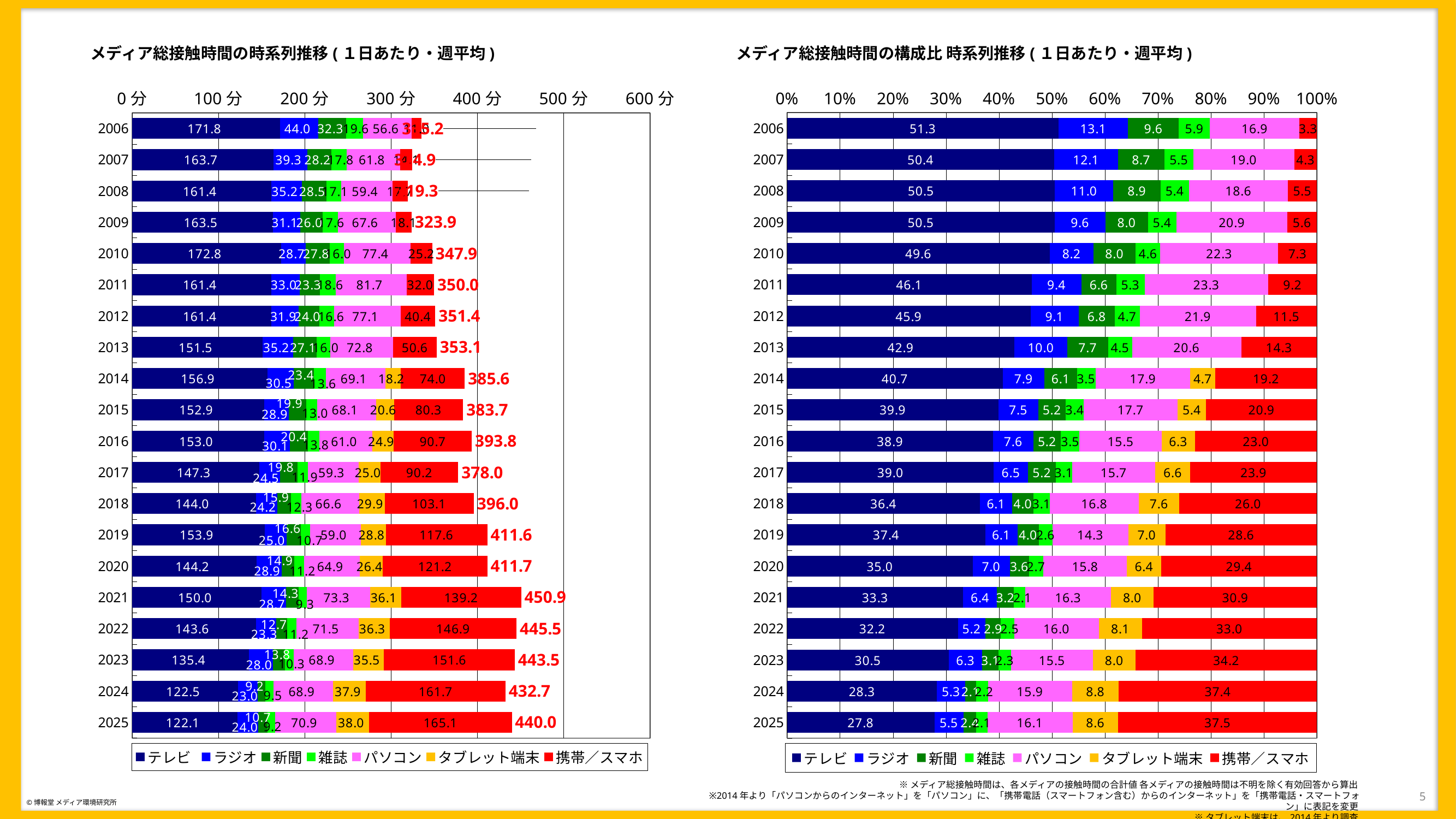
In the left chart (メディア総接触時間の時系列推移), what is the value for テレビ in 2025? 122.1 In the left chart (メディア総接触時間の時系列推移), what is the value for パソコン in 2020? 64.9 What kind of chart is the right chart (メディア総接触時間の構成比 時系列推移)? Stacked bar chart In the left chart (メディア総接触時間の時系列推移), which year has the highest total? 2021 In the left chart (メディア総接触時間の時系列推移), what is the total media contact time shown for 2025? 440.0 In the left chart (メディア総接触時間の時系列推移), what is the difference between 携帯／スマホ and テレビ in 2025? 43.0 In the right chart (メディア総接触時間の構成比 時系列推移), does the share for テレビ rise or fall from 2006 to 2025? Fall In the right chart (メディア総接触時間の構成比 時系列推移), what is the share for テレビ in 2006? 51.3 In the right chart (メディア総接触時間の構成比 時系列推移), what is the share for 携帯／スマホ in 2025? 37.5 How many series does the legend of the left chart list? 7 In the right chart (メディア総接触時間の構成比 時系列推移), which is larger in 2025, テレビ or 携帯／スマホ? 携帯／スマホ In the left chart (メディア総接触時間の時系列推移), what is the value for 携帯／スマホ in 2021? 139.2